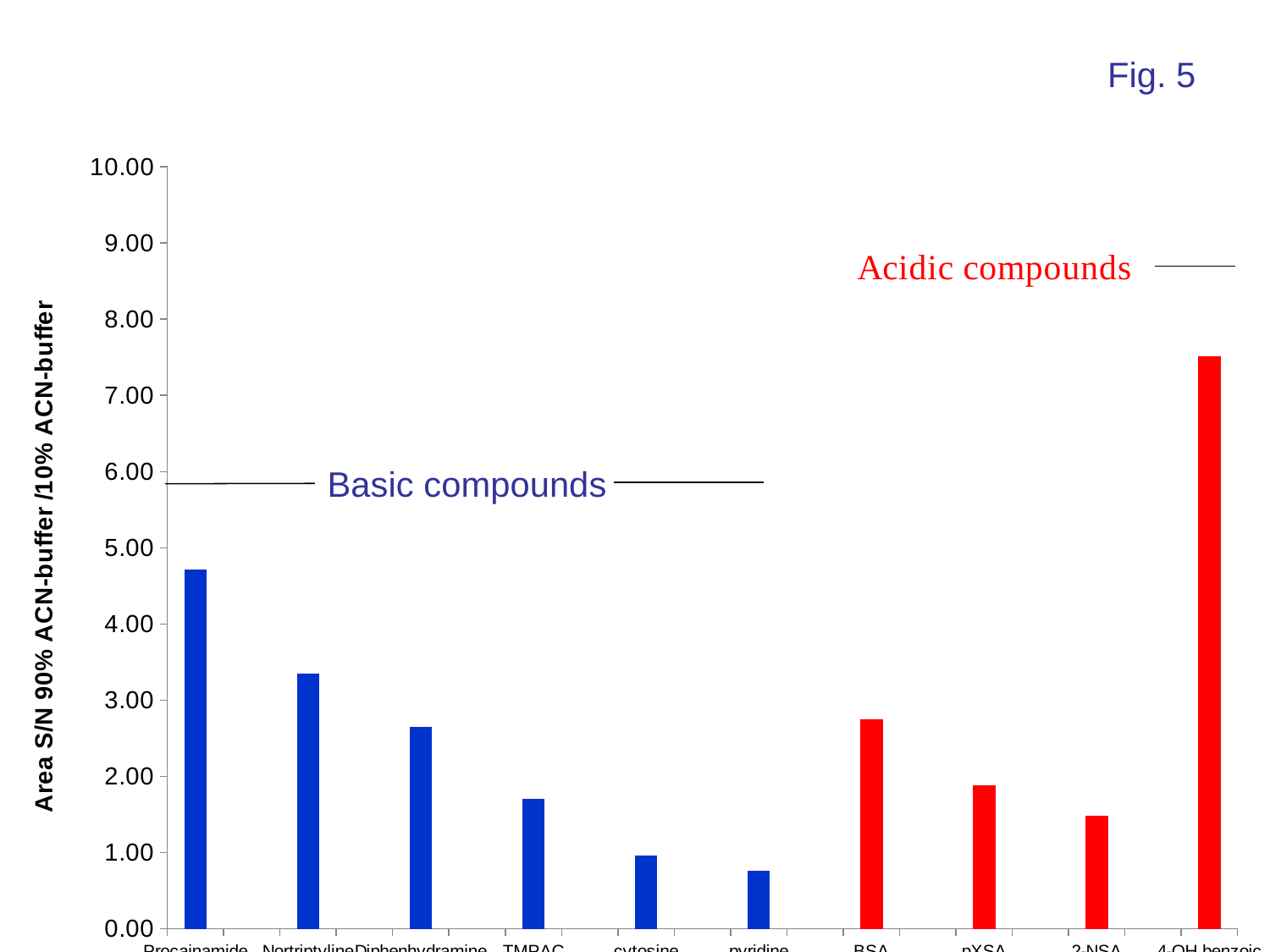
Is the value for Procainamide greater or less than 4.00? greater What kind of chart is shown on the slide? bar chart Is the value for TMPAC greater or less than 2.00? less What colour are the bars for the acidic compounds? red Which compound has the highest bar in the chart? 4-OH benzoic How many bars are plotted in the chart? 10 Which is larger, the value for Procainamide or the value for Nortriptyline? Procainamide Is the value for 4-OH benzoic greater or less than 7.00? greater Do the values for the basic compounds rise or fall from Procainamide to pyridine along the x axis? fall What is the title of the y axis? Area S/N 90% ACN-buffer /10% ACN-buffer